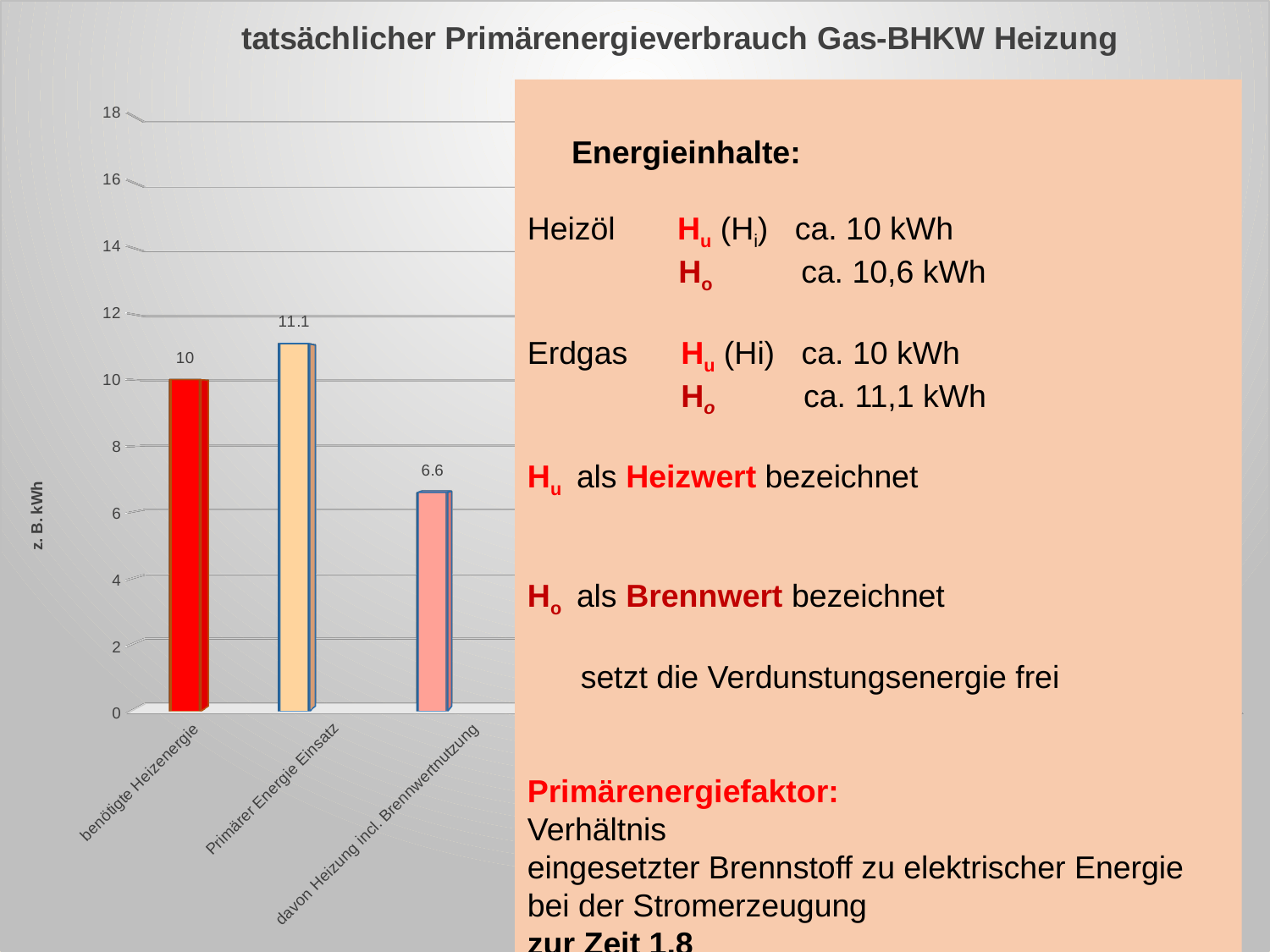
Which is larger, 'benötigte Heizenergie' or 'davon Heizung incl. Brennwertnutzung'? benötigte Heizenergie What is the value for 'Primärer Energie Einsatz'? 11.1 Among the visible bars, which category has the lowest value? davon Heizung incl. Brennwertnutzung What is the value for 'davon Heizung incl. Brennwertnutzung'? 6.6 What kind of chart is shown on the slide? bar chart What is the difference between 'Primärer Energie Einsatz' and 'benötigte Heizenergie'? 1.1 Is the value for 'Primärer Energie Einsatz' greater or less than 12? less What is the title of the chart? tatsächlicher Primärenergieverbrauch Gas-BHKW Heizung What is the difference between 'benötigte Heizenergie' and 'davon Heizung incl. Brennwertnutzung'? 3.4 What is the value for 'benötigte Heizenergie'? 10 What is the label on the vertical axis of the chart? z. B. kWh Among the visible bars, which category has the highest value? Primärer Energie Einsatz